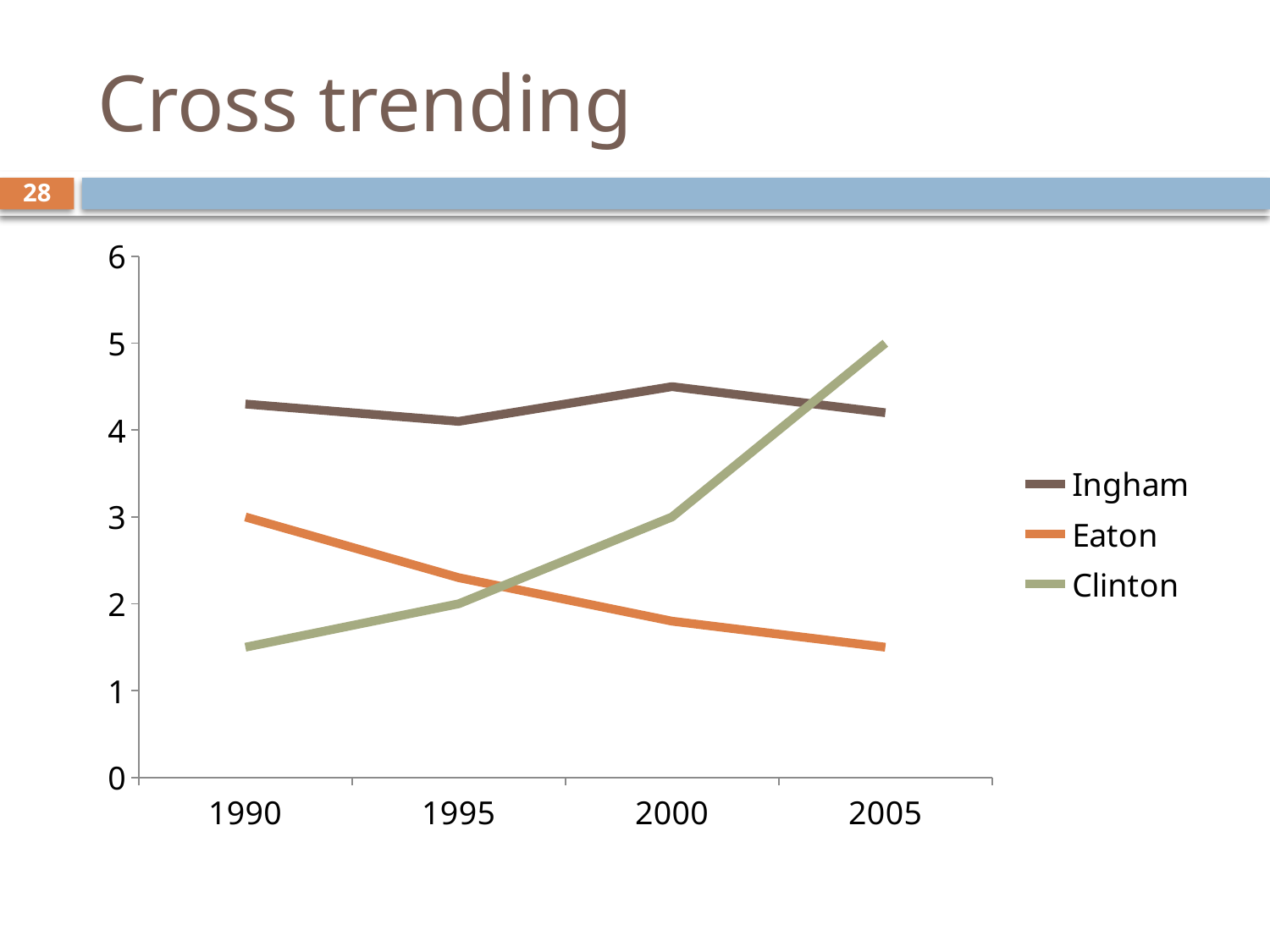
What kind of chart is shown on the slide? line chart Is the value for Eaton in 2005 greater or less than 2? less What is the value for Clinton in 2005? 5 What is the value for Clinton in 2000? 3 In 2005, which is larger, the value for Ingham or the value for Clinton? Clinton How many series does the legend list? 3 Which series has the lowest value in 2005? Eaton How many years are shown on the x axis? 4 Do the values for Eaton rise or fall from 1990 to 2005? fall Which series has the highest value in 1990? Ingham Is the value for Ingham in 1990 greater or less than 4? greater What is the value for Eaton in 1990? 3